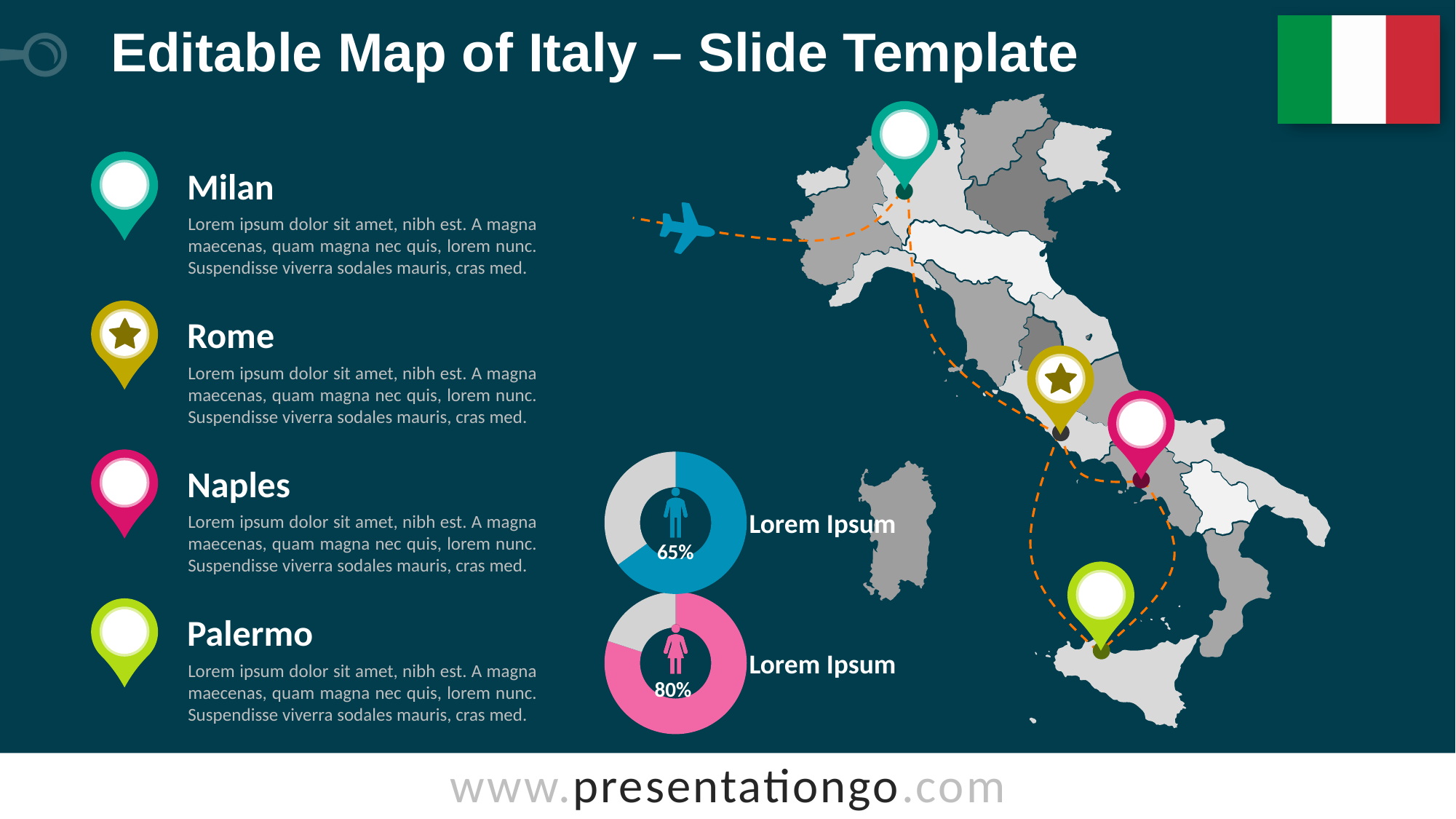
What is the difference between the percentage in the lower pink donut chart and the percentage in the upper blue donut chart? 15 percentage points What label appears to the right of each donut chart? Lorem Ipsum Which donut chart shows the larger percentage, the upper blue one or the lower pink one? the lower pink one How many donut charts are on the slide? 2 In the upper blue donut chart, what share of the ring is left grey (not filled)? 35% What percentage is shown in the lower (pink) donut chart? 80% What kind of chart are the two circular charts at the bottom centre of the slide? donut (pie) charts In the lower pink donut chart, what share of the ring is left grey (not filled)? 20% What colour is the filled portion of the donut chart showing 80%? pink What percentage is shown in the upper (blue) donut chart? 65%